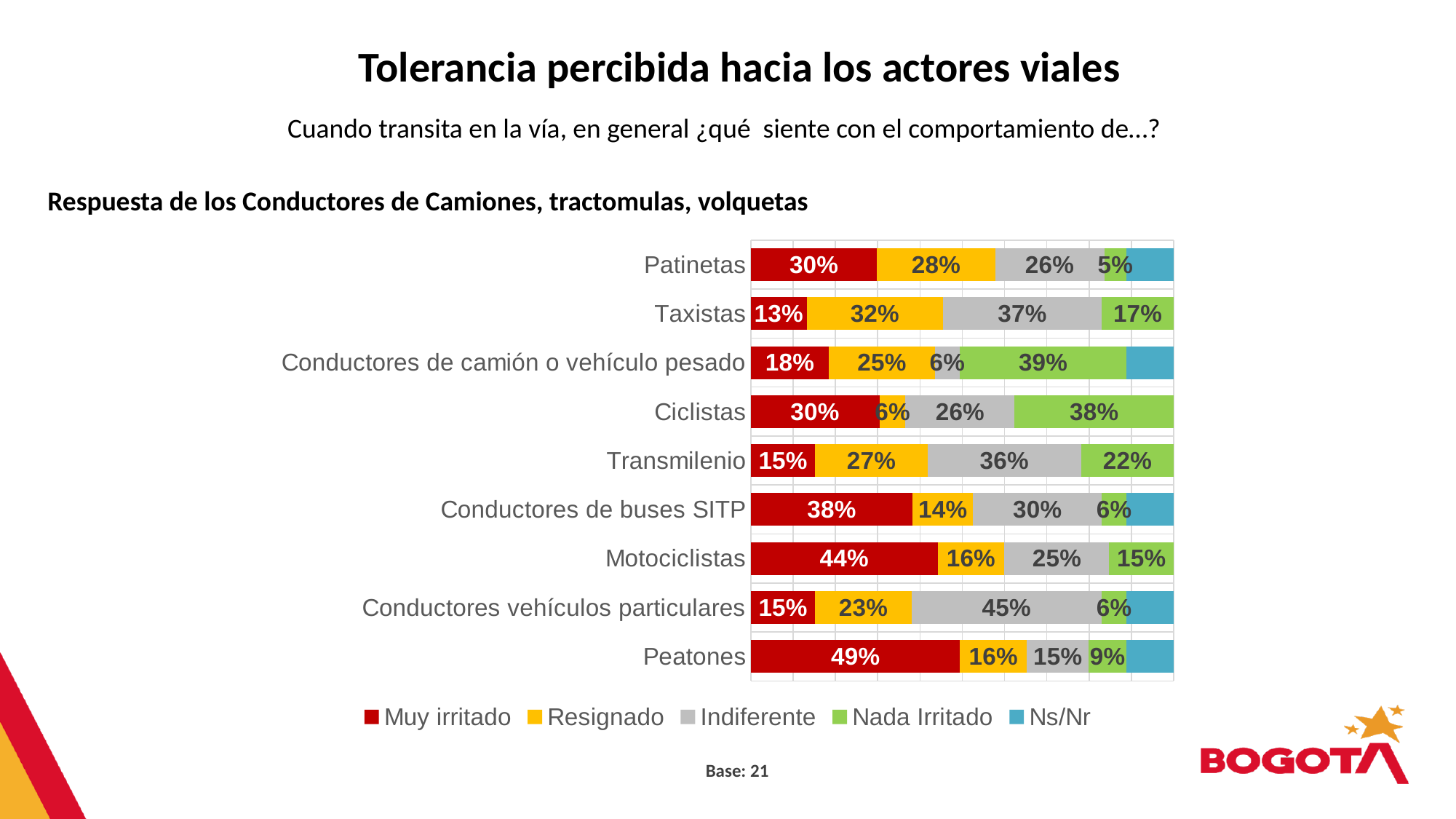
What percentage of respondents are 'Muy irritado' with Motociclistas? 44% What is the difference between the 'Muy irritado' values for Peatones and Motociclistas? 5% How many categories (road actors) are shown on the chart? 9 Which category has the lowest 'Muy irritado' value? Taxistas What is the 'Indiferente' value for Conductores vehículos particulares? 45% What is the 'Nada Irritado' value for Conductores de camión o vehículo pesado? 39% How many series does the legend list? 5 What kind of chart is shown on the slide? Stacked bar chart Which category has the highest 'Muy irritado' value? Peatones What is the difference between the 'Indiferente' values for Conductores vehículos particulares and Taxistas? 8% Which has a larger 'Nada Irritado' value, Ciclistas or Transmilenio? Ciclistas What is the 'Resignado' value for Taxistas? 32%